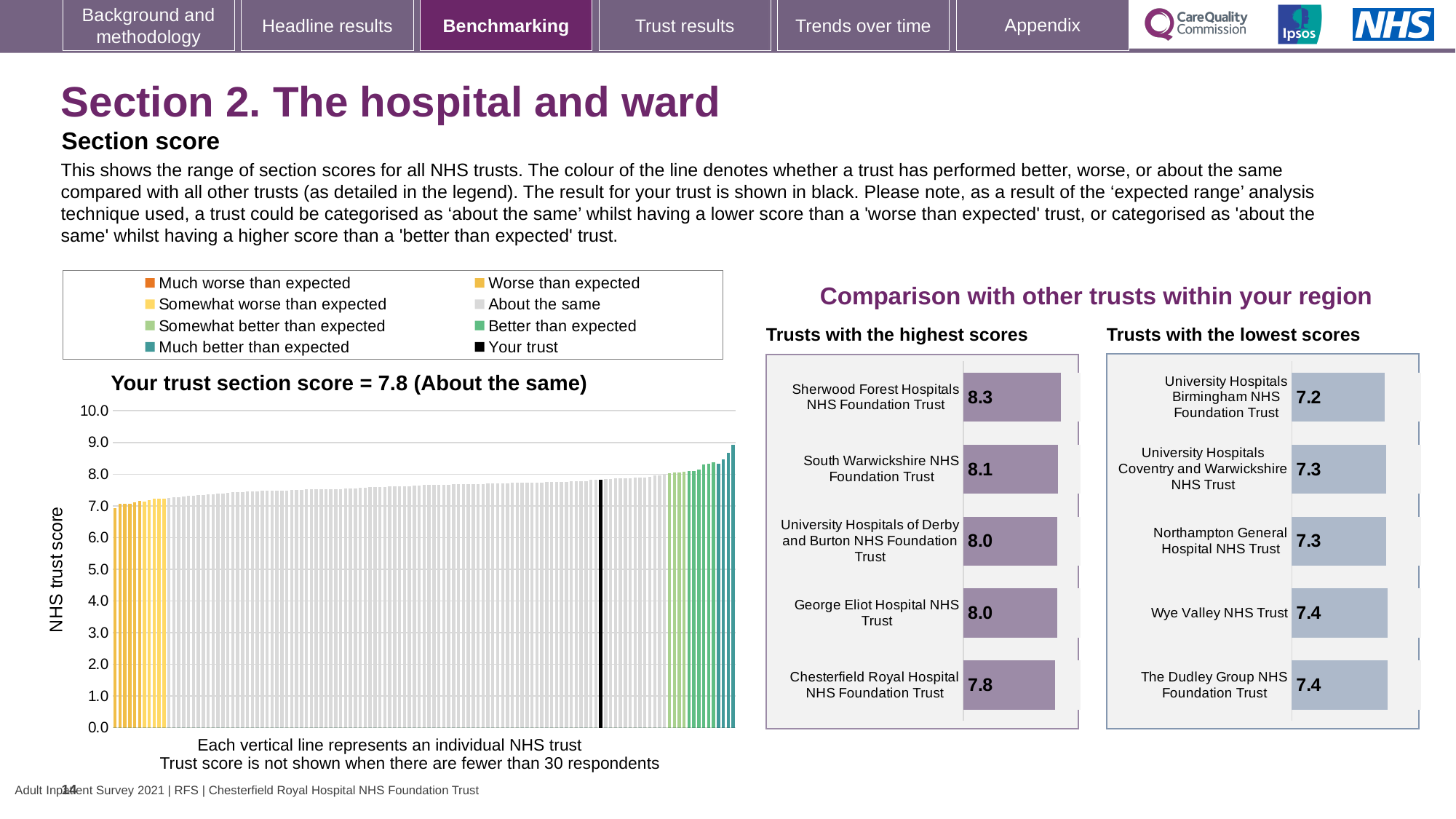
In the 'Trusts with the lowest scores' chart, which trust has the lowest score? University Hospitals Birmingham NHS Foundation Trust In the 'Trusts with the highest scores' chart, what is the score for Sherwood Forest Hospitals NHS Foundation Trust? 8.3 In the 'Your trust section score' chart, what is the section score for your trust? 7.8 What kind of chart is the 'Your trust section score' chart? bar chart In the 'Trusts with the highest scores' chart, how many trusts are listed? 5 In the 'Trusts with the highest scores' chart, which trust has the lowest score shown? Chesterfield Royal Hospital NHS Foundation Trust In the 'Trusts with the lowest scores' chart, what is the score for Wye Valley NHS Trust? 7.4 How many entries does the legend above the 'Your trust section score' chart list? 8 In the 'Trusts with the highest scores' chart, what is the difference between the scores of Sherwood Forest Hospitals NHS Foundation Trust and Chesterfield Royal Hospital NHS Foundation Trust? 0.5 In the 'Trusts with the lowest scores' chart, is the score for Northampton General Hospital NHS Trust larger or smaller than the score for The Dudley Group NHS Foundation Trust? smaller In the 'Your trust section score' chart, do the trust scores rise or fall from left to right? rise In the 'Trusts with the lowest scores' chart, what is the score for University Hospitals Birmingham NHS Foundation Trust? 7.2